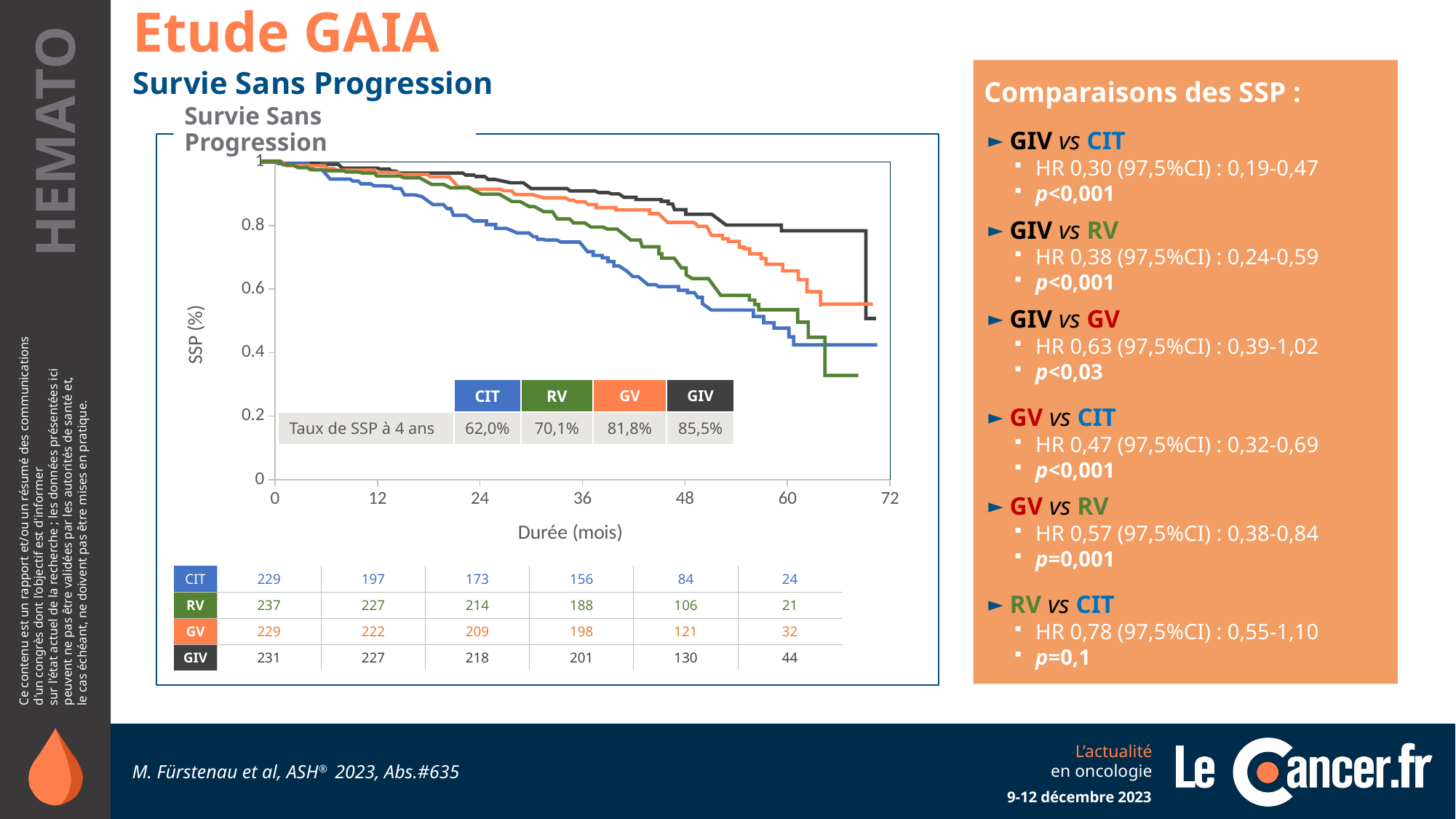
Which arm has the highest 'Taux de SSP à 4 ans'? GIV Do the survival curves rise or fall as the duration in months increases? fall What kind of chart is shown on the slide? line chart Which arm has the lowest 'Taux de SSP à 4 ans'? CIT How many series does the legend of the chart list? 4 Is the value of the GIV curve at 48 months greater or less than 0.8? greater What is the title of the x axis of the chart? Durée (mois) What is the 'Taux de SSP à 4 ans' for GV? 81,8% What is the difference between the 4-year SSP rates of GIV and CIT? 23,5 points What is the 'Taux de SSP à 4 ans' for RV? 70,1% Which arm has the higher 4-year SSP rate, GV or RV? GV What is the 'Taux de SSP à 4 ans' for CIT? 62,0%